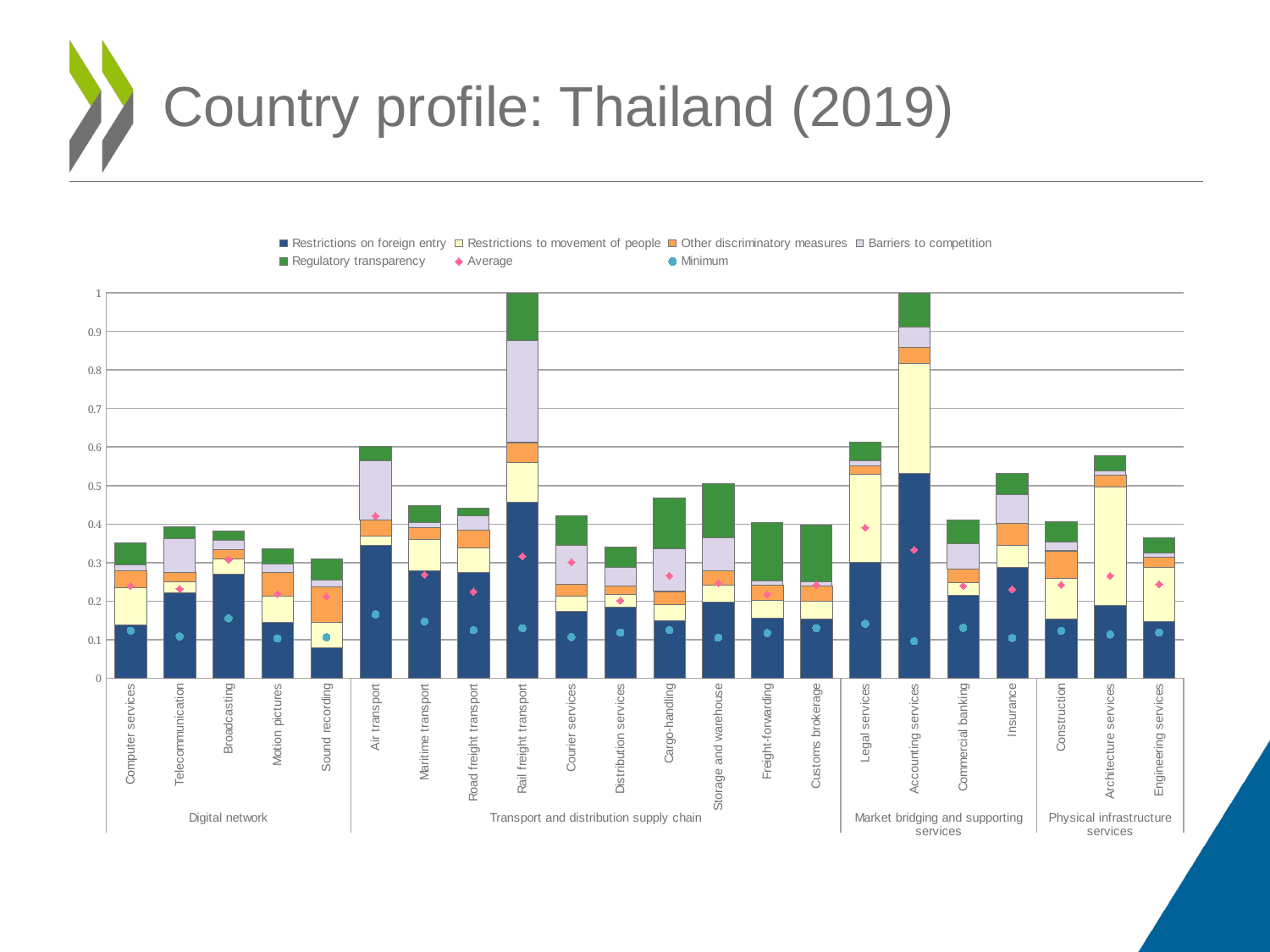
How many service categories are plotted along the x axis? 22 What kind of chart is shown on the slide? Stacked bar chart How many sector groups are labelled beneath the x axis? 4 Is the total stacked value for Architecture services greater or less than 0.5? greater Is the total stacked value for Cargo-handling greater or less than 0.4? greater Which series is represented by the pink diamond markers in the legend? Average Is the total stacked value for Sound recording greater or less than 0.4? less How many series does the legend list? 7 Which has the larger total stacked value, Cargo-handling or Computer services? Cargo-handling Which has the larger total stacked value, Air transport or Courier services? Air transport